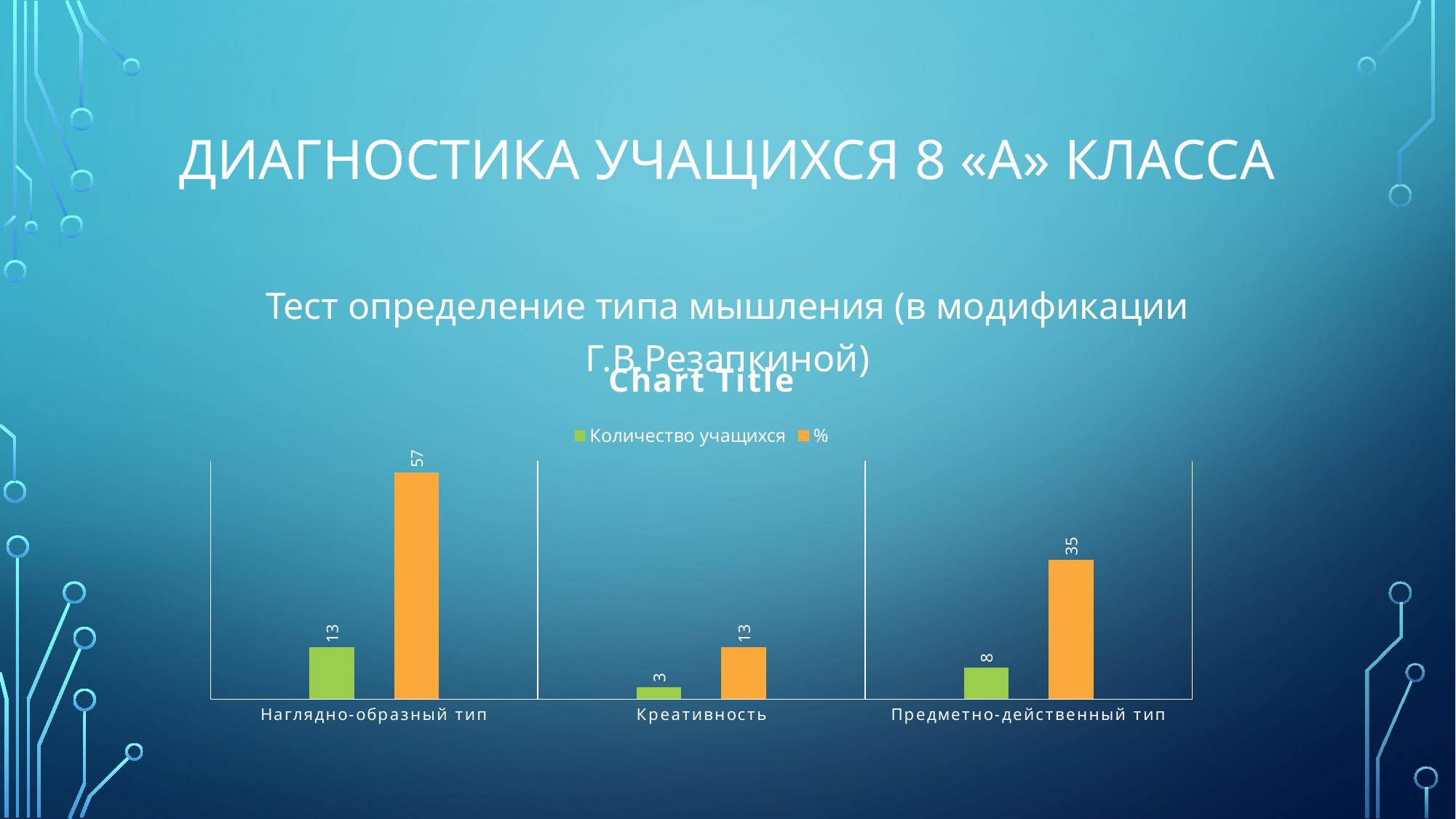
How many series does the legend list? 2 How many categories are shown on the x axis? 3 What is the value of Количество учащихся for Наглядно-образный тип? 13 Which category has the lowest value for Количество учащихся? Креативность What is the difference between the % values for Наглядно-образный тип and Предметно-действенный тип? 22 What is the % value for Предметно-действенный тип? 35 What type of chart is shown on the slide? bar chart What is the title shown above the chart? Chart Title Which category has the highest % value? Наглядно-образный тип Which is larger: Количество учащихся for Наглядно-образный тип or for Предметно-действенный тип? Наглядно-образный тип What is the value of Количество учащихся for Предметно-действенный тип? 8 What is the % value for Креативность? 13